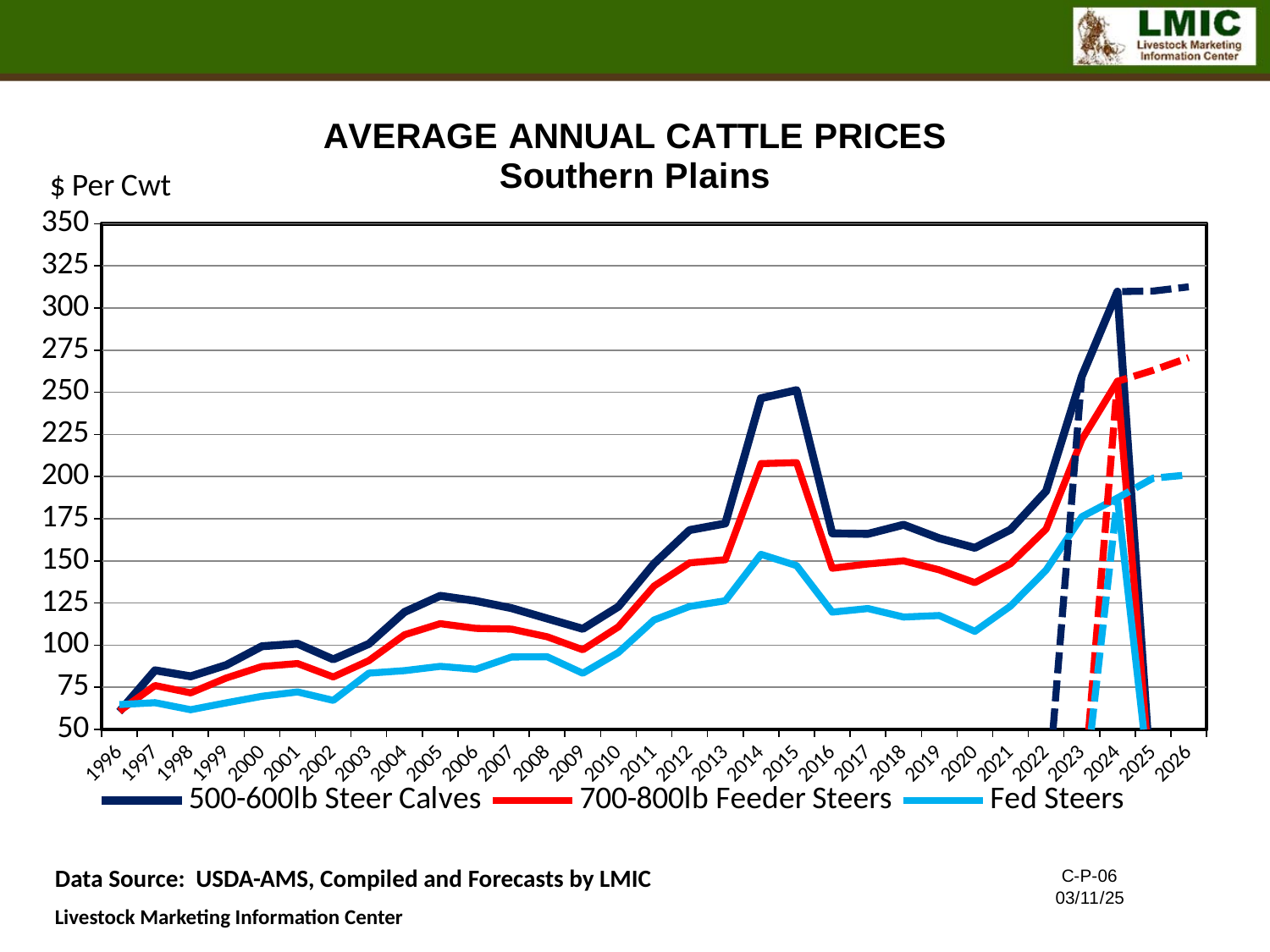
Which series has the highest value in 2024? 500-600lb Steer Calves Is the value for 700-800lb Feeder Steers in 2015 greater or less than 175? greater What unit is shown on the y axis label? $ Per Cwt How many years are labelled on the x axis? 31 Do the 500-600lb Steer Calves values rise or fall from 2020 to 2024? rise How many series does the legend list? 3 Is the value for 500-600lb Steer Calves in 2024 greater or less than 300? greater Is the value for 500-600lb Steer Calves in 2014 greater or less than 225? greater What kind of chart is shown on the slide? line chart In 2016, which is larger: 700-800lb Feeder Steers or Fed Steers? 700-800lb Feeder Steers Which series has the lowest value in 2020? Fed Steers